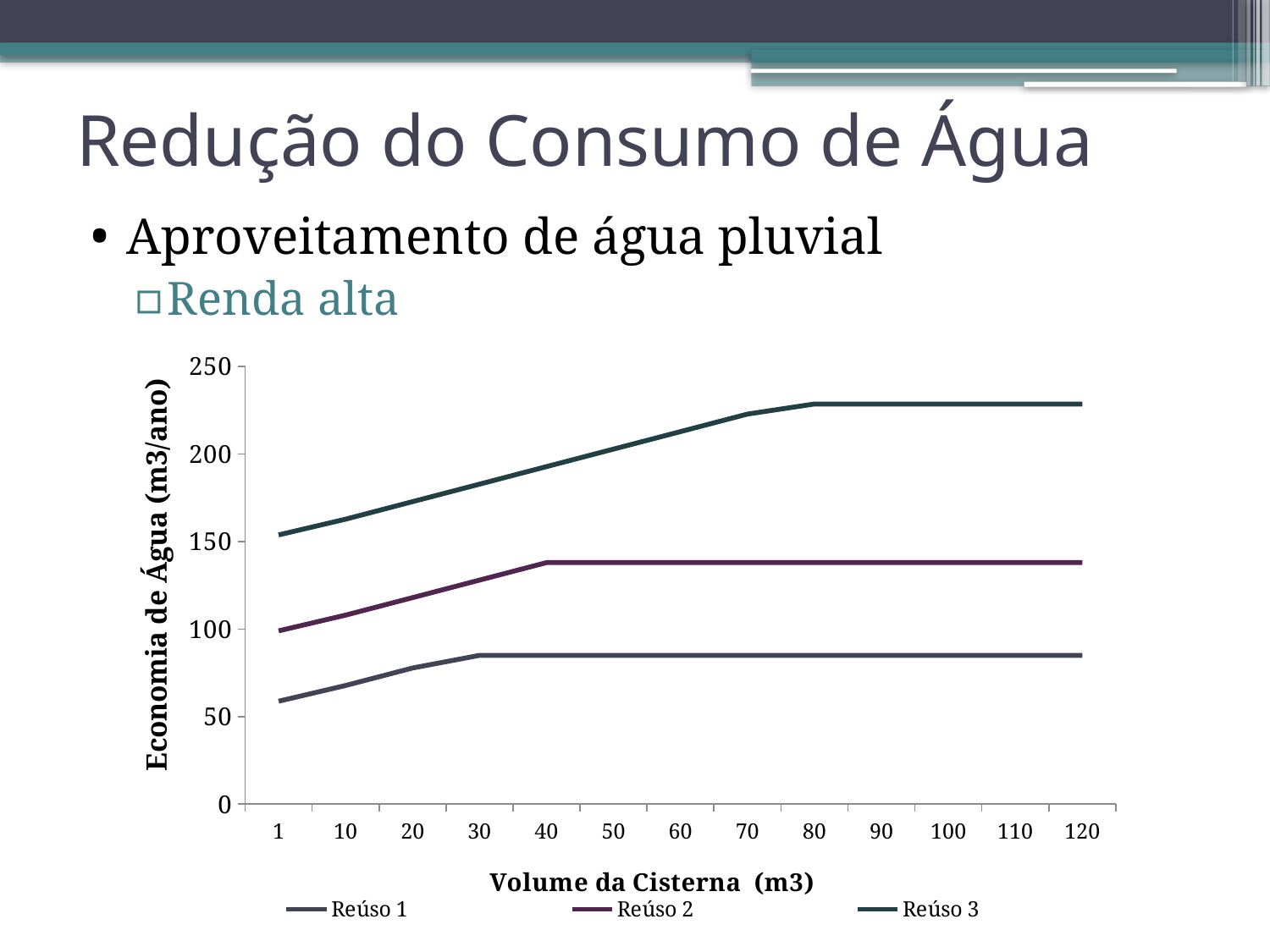
What is the title of the x axis? Volume da Cisterna (m3) At a cistern volume of 120, which is larger: Reúso 3 or Reúso 1? Reúso 3 Is the value for Reúso 3 at a cistern volume of 120 greater or less than 200? greater Is the value for Reúso 1 at a cistern volume of 1 greater or less than 100? less Is the value for Reúso 2 at a cistern volume of 120 greater or less than 150? less Which series has the lowest values across the chart? Reúso 1 Which series has the highest values across the chart? Reúso 3 What is the title of the y axis? Economia de Água (m3/ano) How many points are marked along the x axis (Volume da Cisterna)? 13 Do the values for Reúso 3 rise or fall as the cistern volume increases from 1 to 80? rise What kind of chart is shown on the slide? line chart How many series does the legend list? 3